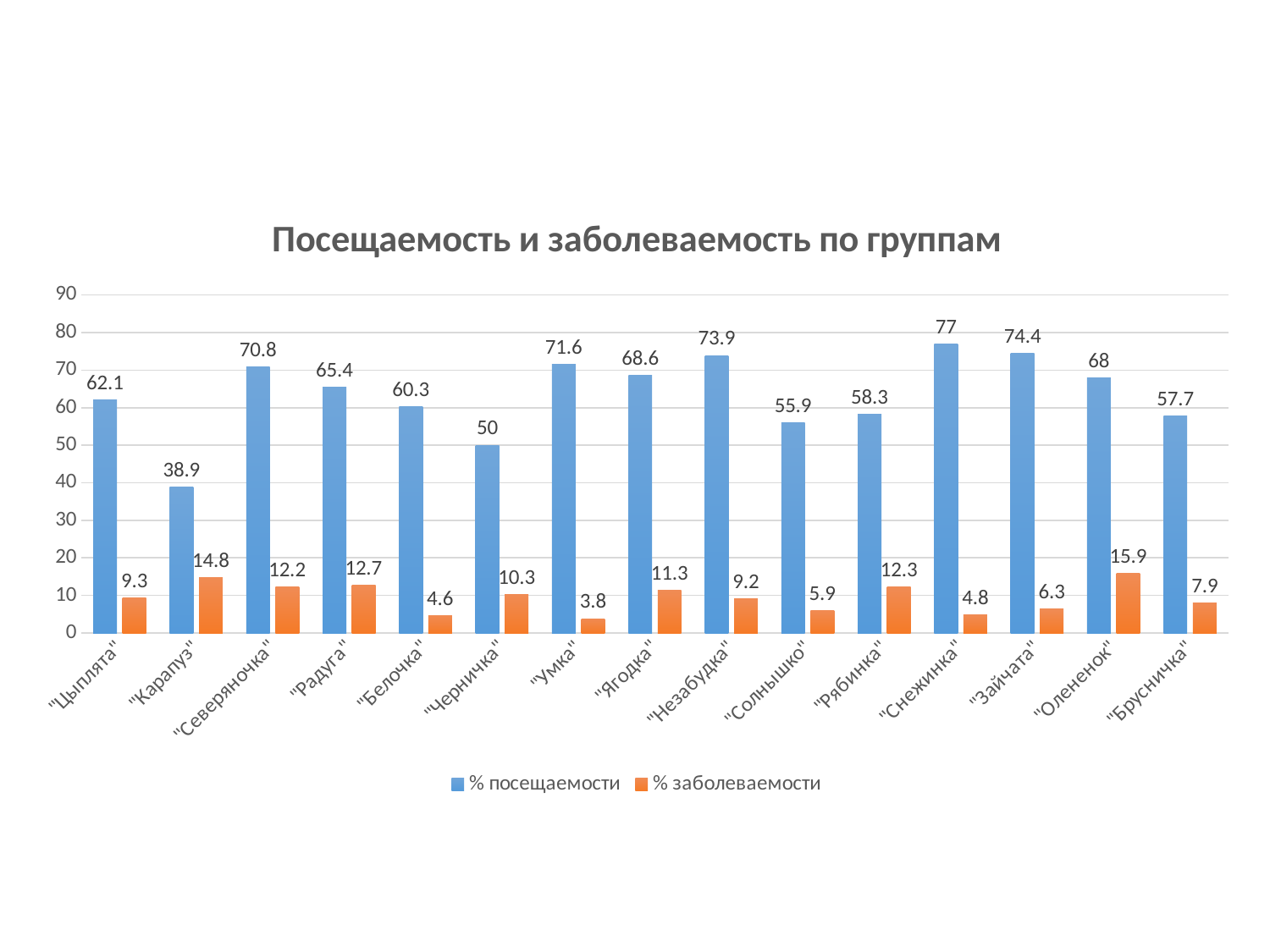
What is the % посещаемости value for "Северяночка"? 70.8 Which group has the highest % заболеваемости? "Олененок" What is the difference between the % посещаемости values for "Цыплята" and "Карапуз"? 23.2 Which group has the highest % посещаемости? "Снежинка" Is the % посещаемости value for "Черничка" greater or less than 60? less How many groups are shown on the x axis? 15 What is the % заболеваемости value for "Олененок"? 15.9 Which group has the lowest % посещаемости? "Карапуз" Which is larger: the % заболеваемости for "Радуга" or for "Рябинка"? "Радуга" Which group has the lowest % заболеваемости? "Умка" What type of chart is shown on the slide? bar chart How many series does the legend list? 2